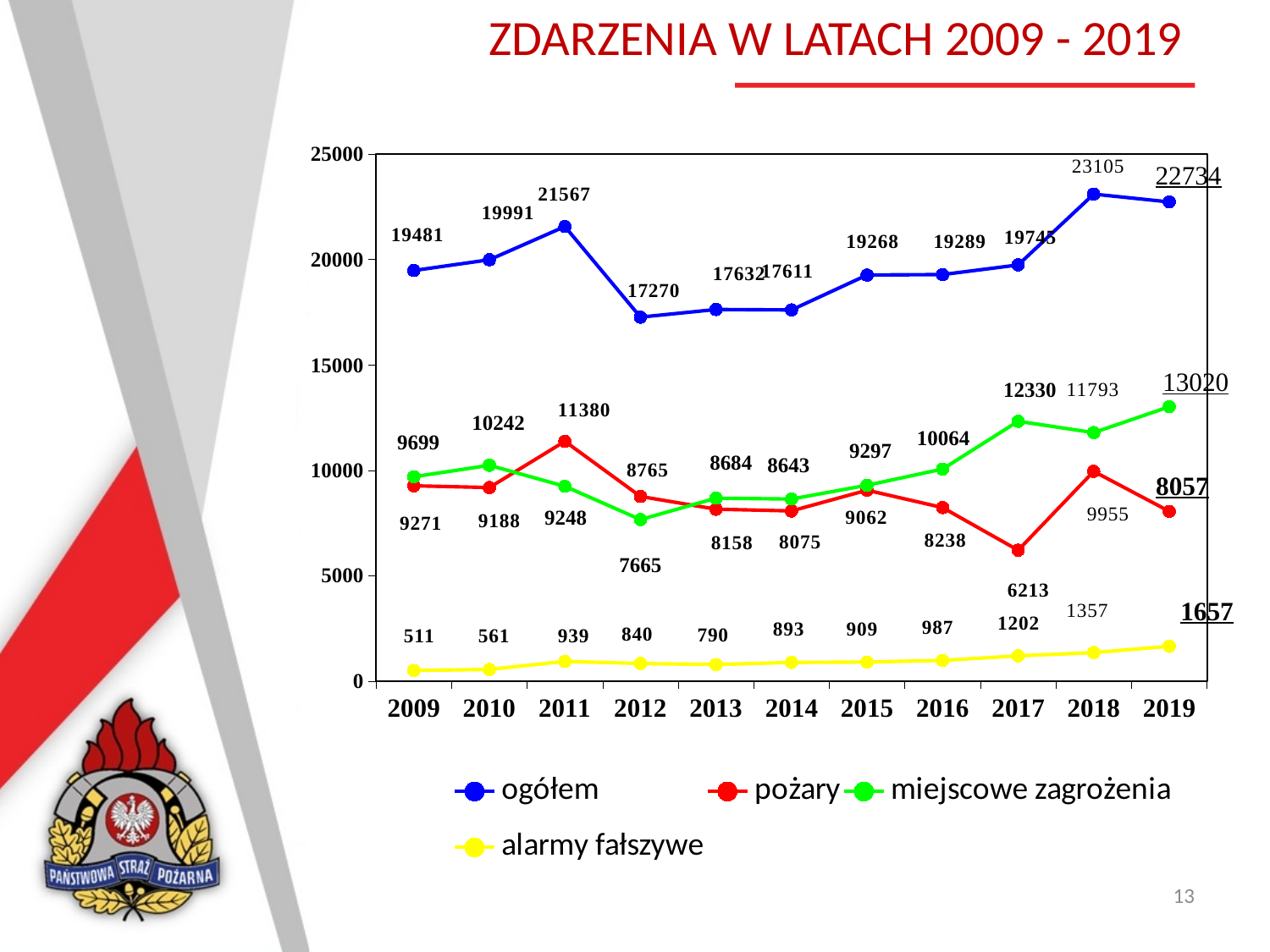
What is the difference between ogółem in 2018 and in 2019? 371 Is the value of ogółem in 2012 greater or less than 20000? less How many series does the legend list? 4 What is the value of ogółem in 2019? 22734 In which year is pożary lowest? 2017 In which year is ogółem highest? 2018 What kind of chart is shown on the slide? line chart What is the value of miejscowe zagrożenia in 2019? 13020 What is the value of pożary in 2017? 6213 In which year is alarmy fałszywe lowest? 2009 In 2017, which is larger: pożary or miejscowe zagrożenia? miejscowe zagrożenia How many years are shown on the x axis? 11